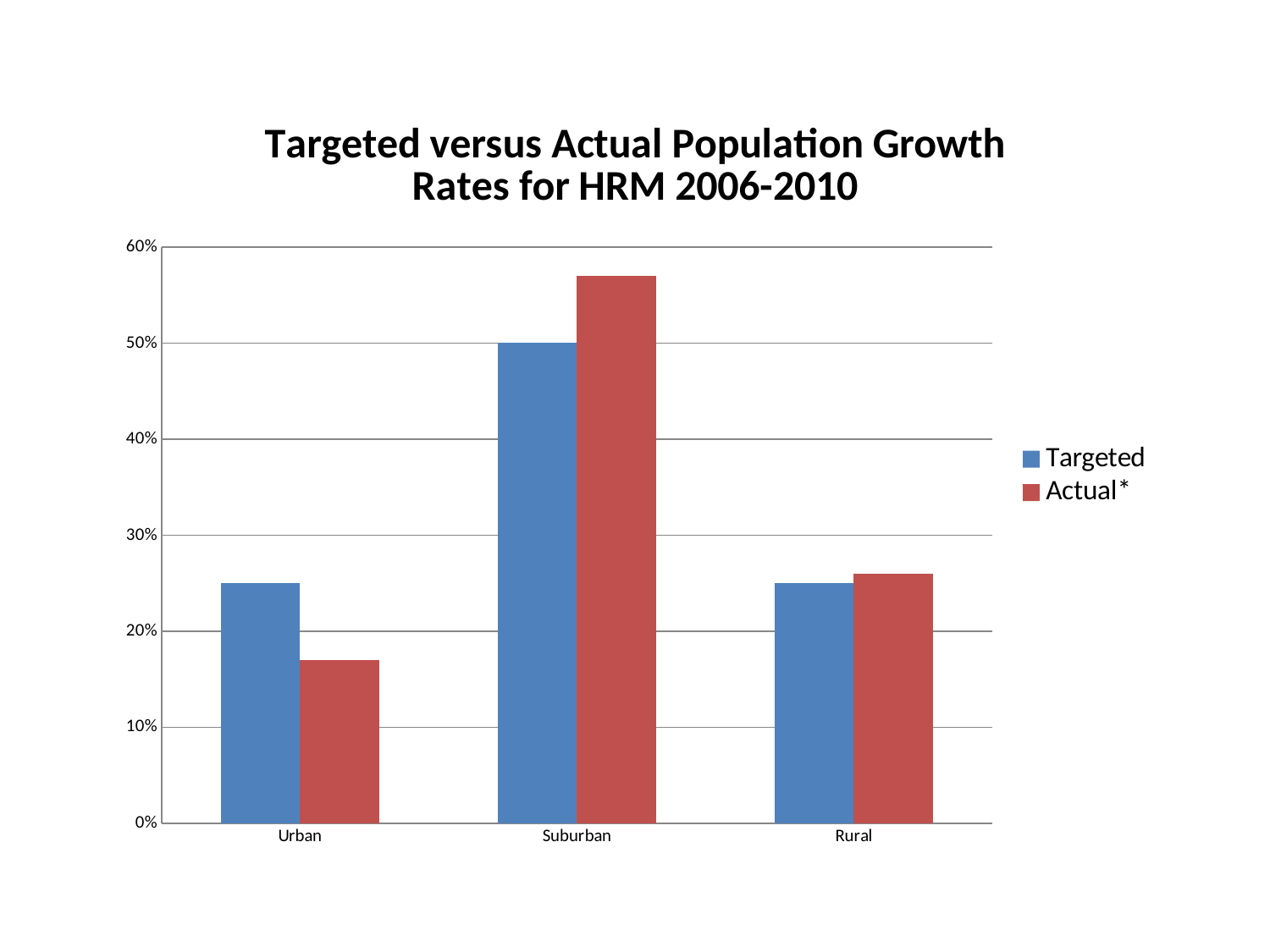
Which category has the lowest Actual* value? Urban Which category has the highest Targeted value? Suburban How many series does the legend list? 2 What is the title of the chart? Targeted versus Actual Population Growth Rates for HRM 2006-2010 What type of chart is shown on the slide? bar chart Is the Targeted value for Rural greater or less than 30%? less For Urban, which is larger: the Targeted value or the Actual* value? Targeted Is the Actual* value for Urban greater or less than 20%? less Which category has the highest Actual* value? Suburban What is the Targeted value for Suburban? 50% Is the Actual* value for Suburban greater or less than 50%? greater How many categories are shown on the x axis? 3